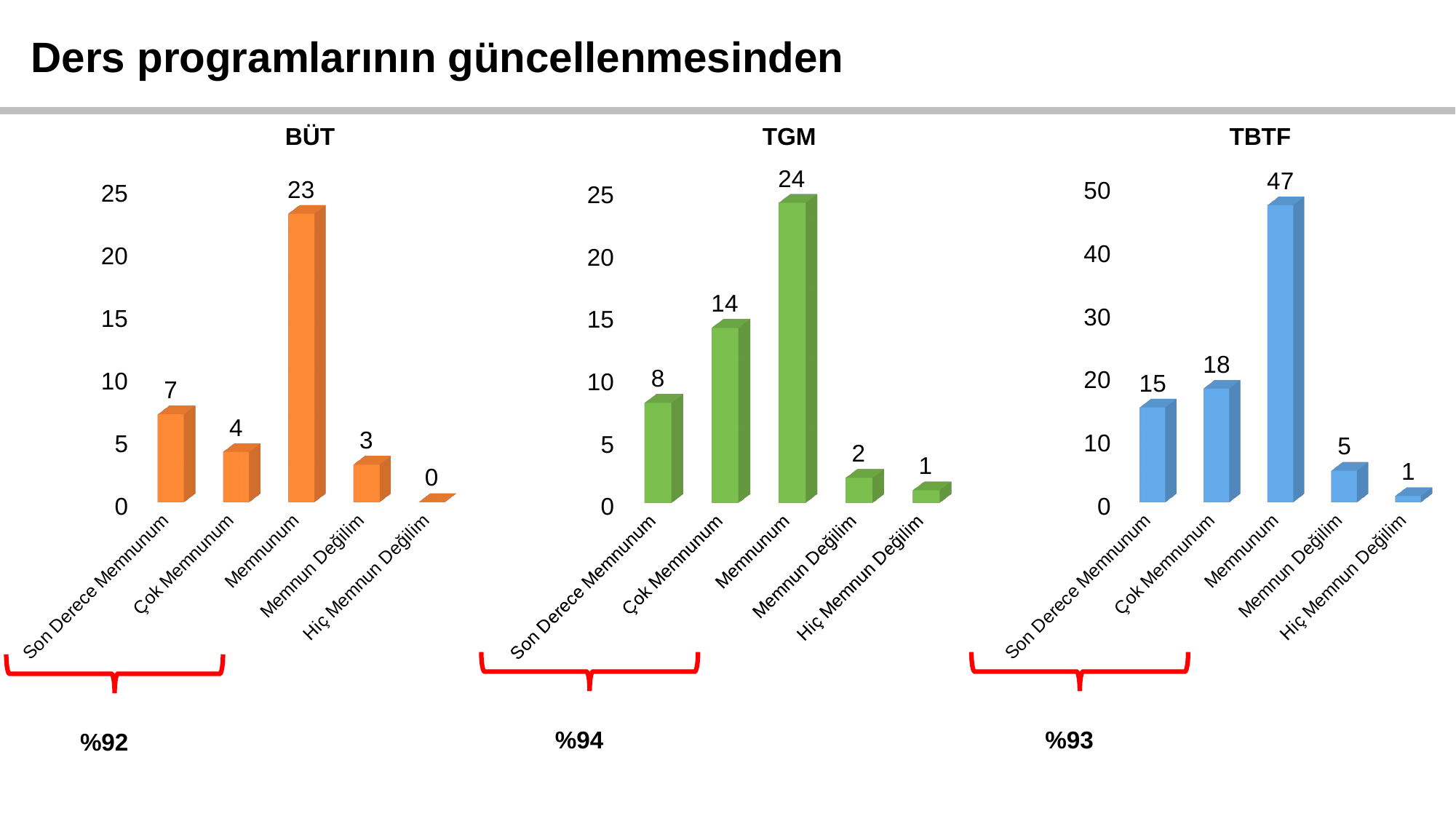
In the TBTF chart, which is larger: Çok Memnunum or Son Derece Memnunum? Çok Memnunum In the BÜT chart, how many categories are shown on the x axis? 5 In the TGM chart, what is the value for Çok Memnunum? 14 In the TGM chart, what is the difference between Memnunum and Çok Memnunum? 10 In the BÜT chart, what is the value for Memnunum? 23 What is the title of the chart on the right of the slide? TBTF In the BÜT chart, what is the difference between Son Derece Memnunum and Çok Memnunum? 3 In the TBTF chart, what is the value for Son Derece Memnunum? 15 In the BÜT chart, which category has the lowest value? Hiç Memnun Değilim In the TBTF chart, which category has the highest value? Memnunum In the TBTF chart, what is the value for Hiç Memnun Değilim? 1 What type of chart is the TGM chart? Bar chart